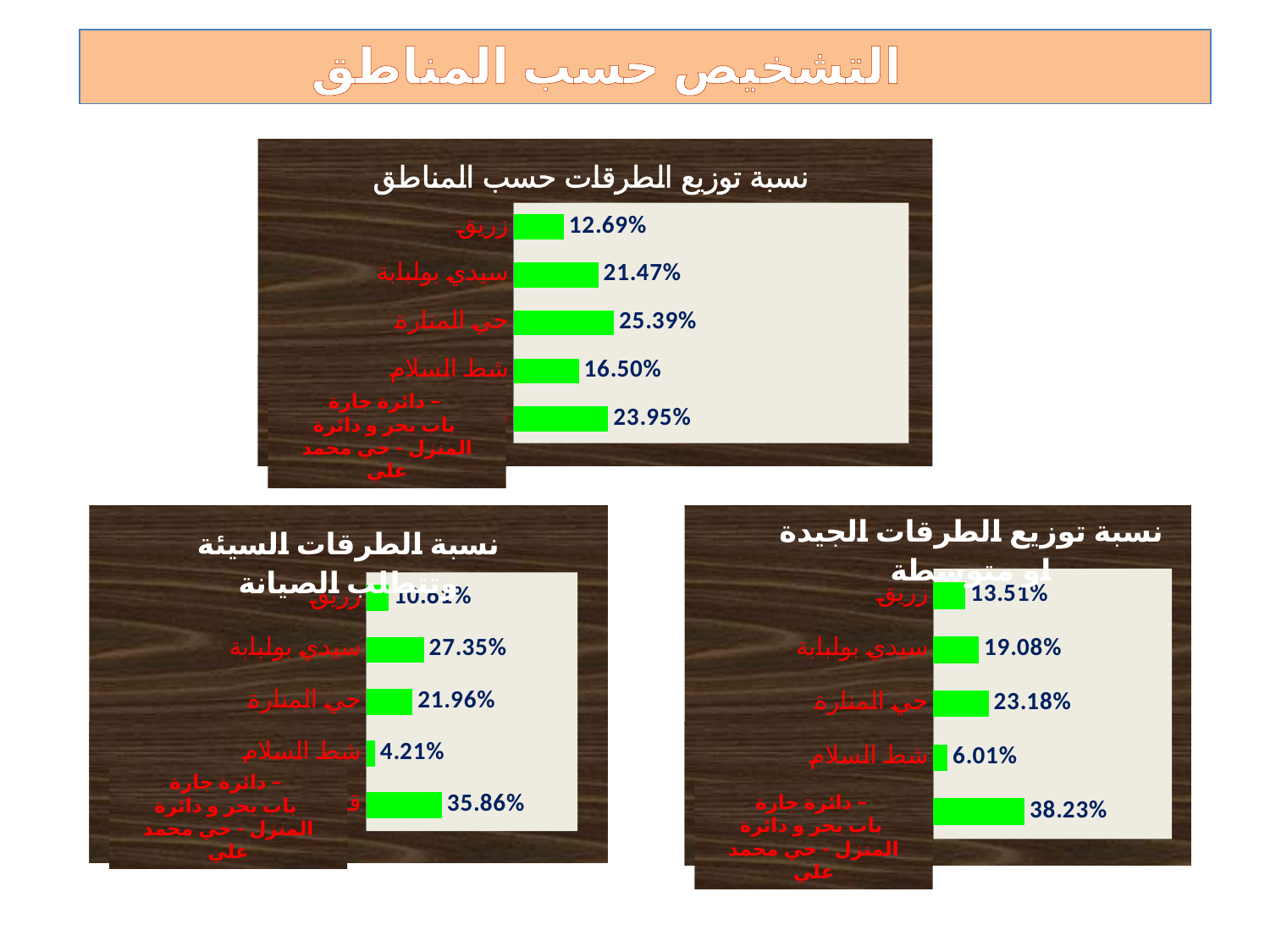
In the bottom-right chart (نسبة توزيع الطرقات الجيدة أو متوسطة), what is the value for سيدي بولبابة? 19.08% In the top chart (نسبة توزيع الطرقات حسب المناطق), which category has the highest value? حي المنارة In the bottom-right chart (نسبة توزيع الطرقات الجيدة أو متوسطة), what is the difference between the values for حي المنارة and زريق? 9.67% In the bottom-right chart (نسبة توزيع الطرقات الجيدة أو متوسطة), which category has the lowest value? شط السلام How many categories does the top chart (نسبة توزيع الطرقات حسب المناطق) show? 5 In the bottom-left chart (نسبة الطرقات السيئة وتتطلب الصيانة), which category has the highest value? دائرة جارة باب بحر و دائرة المنزل - حي محمد علي In the top chart (نسبة توزيع الطرقات حسب المناطق), what is the value for حي المنارة? 25.39% In the top chart (نسبة توزيع الطرقات حسب المناطق), which category has the lowest value? زريق In the bottom-left chart (نسبة الطرقات السيئة وتتطلب الصيانة), which is larger, the value for سيدي بولبابة or the value for حي المنارة? سيدي بولبابة In the top chart (نسبة توزيع الطرقات حسب المناطق), what is the value for زريق? 12.69% In the top chart (نسبة توزيع الطرقات حسب المناطق), what is the difference between the values for سيدي بولبابة and شط السلام? 4.97% In the bottom-left chart (نسبة الطرقات السيئة وتتطلب الصيانة), what is the value for شط السلام? 4.21%